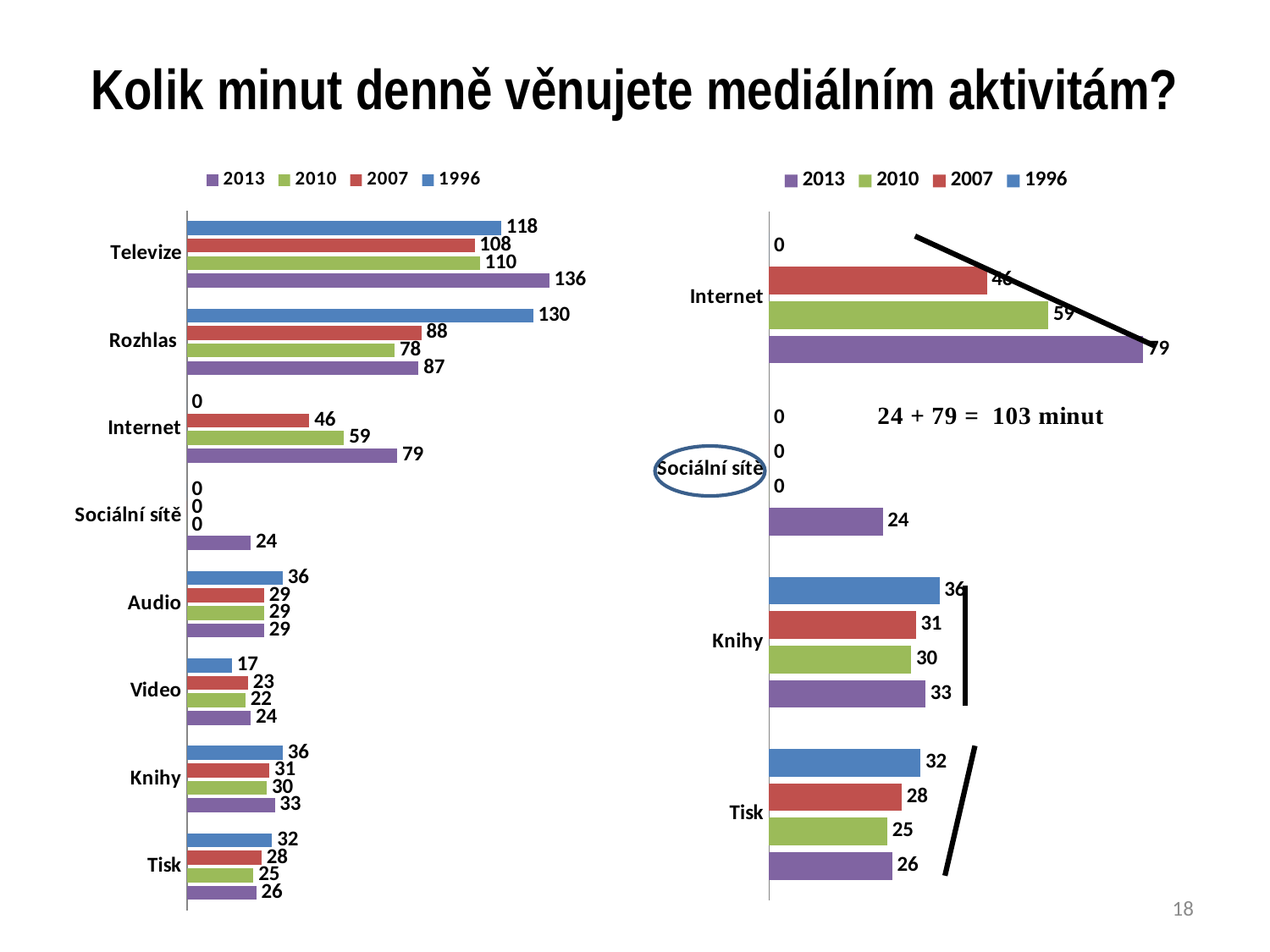
In the left chart, which category has the highest value for the 2013 series? Televize In the left chart, which is larger for Rozhlas: the 2007 value or the 2010 value? 2007 How many categories does the left chart show? 8 What kind of chart is the right chart? bar chart How many series does the legend of the right chart list? 4 In the left chart, what is the difference between the 2013 and 1996 values for Televize? 18 In the left chart, what is the value for Televize in 2013? 136 In the left chart, what is the value for Rozhlas in 1996? 130 In the right chart, what is the value for Sociální sítě in 2013? 24 In the left chart, which category has the lowest value for the 1996 series? Internet and Sociální sítě (both 0) In the right chart, how do the values for Internet change from 2007 to 2013? They rise In the right chart, what is the value for Knihy in 2007? 31